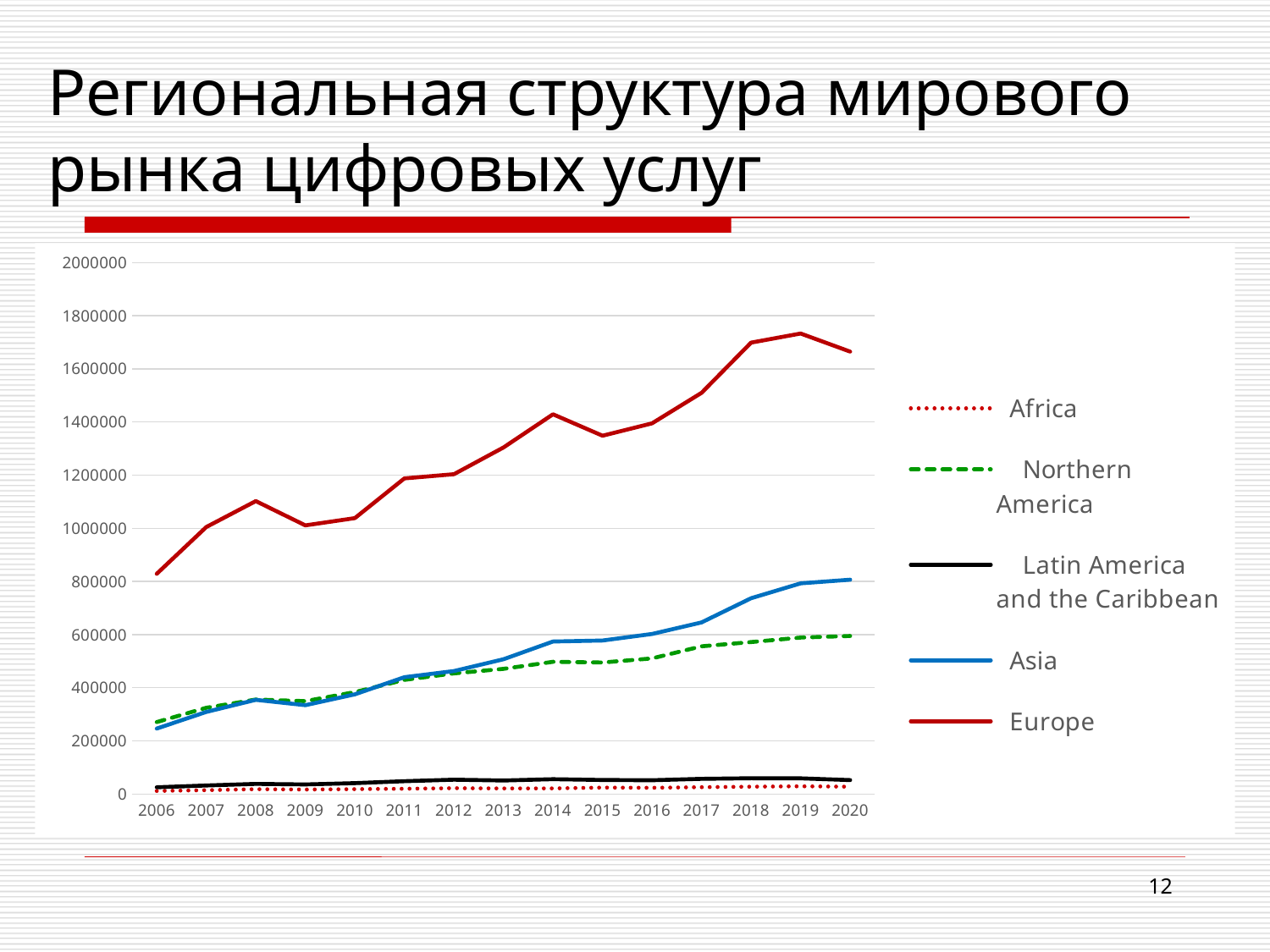
Which region has the lowest values throughout the chart? Africa Is the value for Asia in 2020 greater or less than 600000? greater In 2020, which is larger: the value for Asia or the value for Northern America? Asia How many years are shown along the x axis? 15 Is the value for Europe in 2006 greater or less than 1000000? less Which series is drawn with a dotted red line? Africa Is the value for Europe in 2019 greater or less than 1600000? greater Does the Europe line generally rise or fall from 2006 to 2020? rise What kind of chart is shown on the slide? line chart How many series does the legend list? 5 Which region has the highest values throughout the chart? Europe